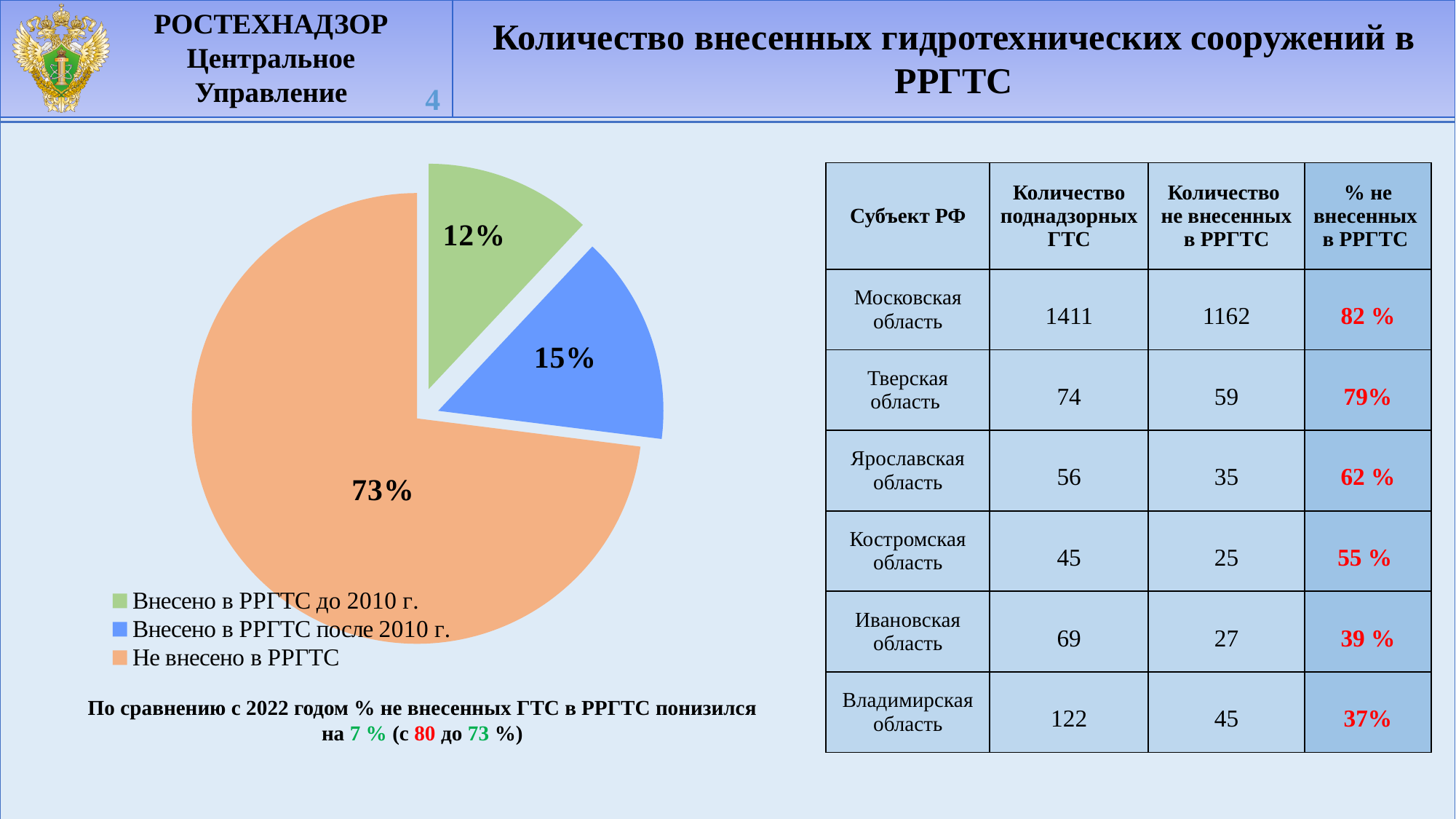
How many entries does the pie chart legend list? 3 What share of the pie chart is labelled "Внесено в РРГТС до 2010 г."? 12% What share of the pie chart is labelled "Не внесено в РРГТС"? 73% What type of chart is shown on the slide? pie chart Which is larger in the pie chart: "Внесено в РРГТС до 2010 г." or "Внесено в РРГТС после 2010 г."? Внесено в РРГТС после 2010 г. What colour is the "Не внесено в РРГТС" slice in the pie chart? orange What is the combined share of the two "Внесено в РРГТС" slices in the pie chart? 27% What share of the pie chart is labelled "Внесено в РРГТС после 2010 г."? 15% How many slices does the pie chart have? 3 What is the difference in percentage points between the "Не внесено в РРГТС" slice and the "Внесено в РРГТС после 2010 г." slice? 58% Which category has the largest slice in the pie chart? Не внесено в РРГТС Which category has the smallest slice in the pie chart? Внесено в РРГТС до 2010 г.